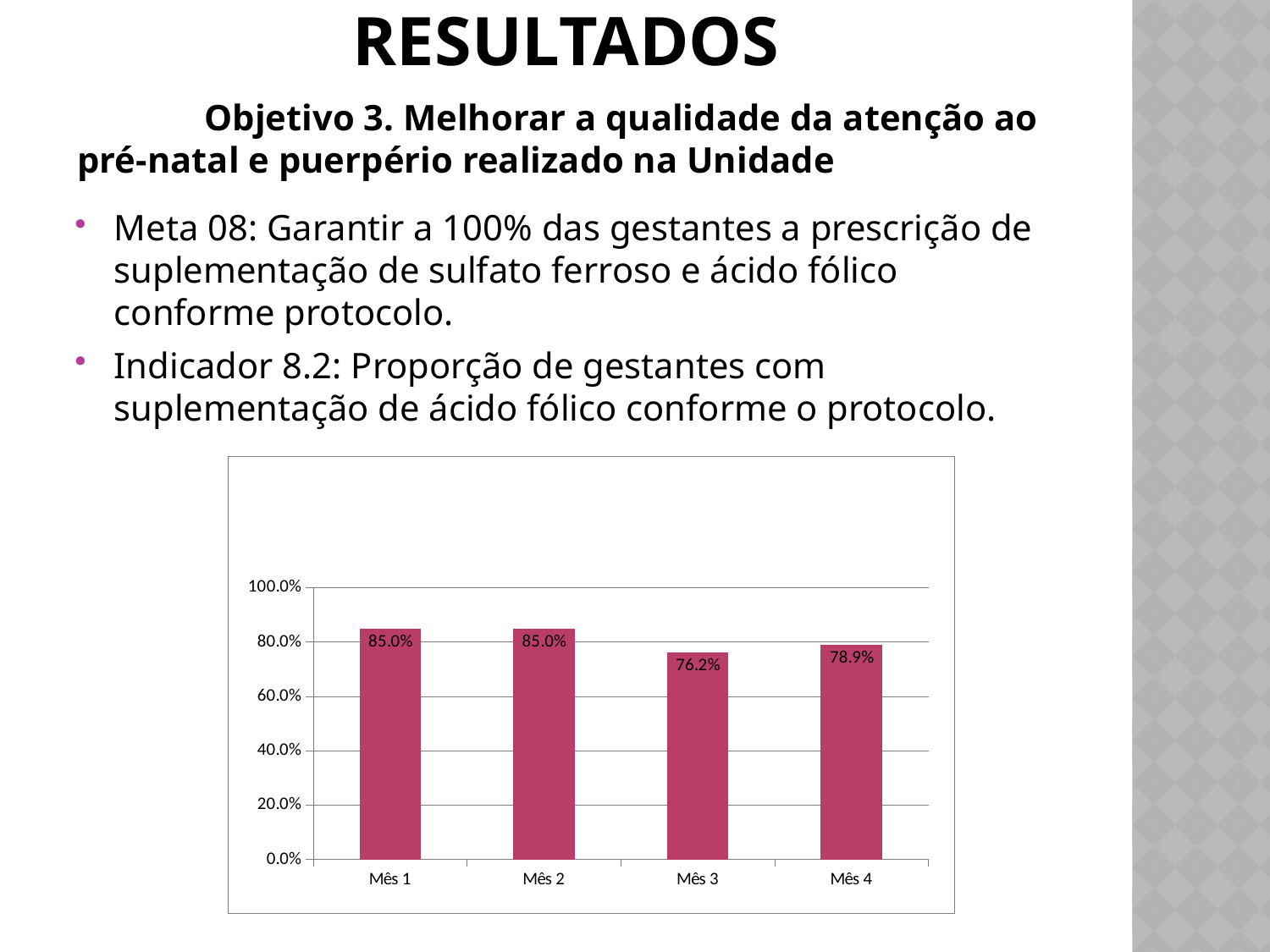
Is the value for Mês 3 greater or less than 80.0%? less Do the values for Mês 1 and Mês 2 differ? No, both are 85.0% What is the value for Mês 1? 85.0% What is the difference between the values for Mês 4 and Mês 3? 2.7% What kind of chart is shown on the slide? bar chart How many months are shown on the x axis? 4 Which is larger, the value for Mês 2 or the value for Mês 4? Mês 2 Which month has the lowest value? Mês 3 What is the difference between the values for Mês 1 and Mês 3? 8.8% Is the value for Mês 1 greater or less than 80.0%? greater What is the value for Mês 4? 78.9% What is the value for Mês 3? 76.2%